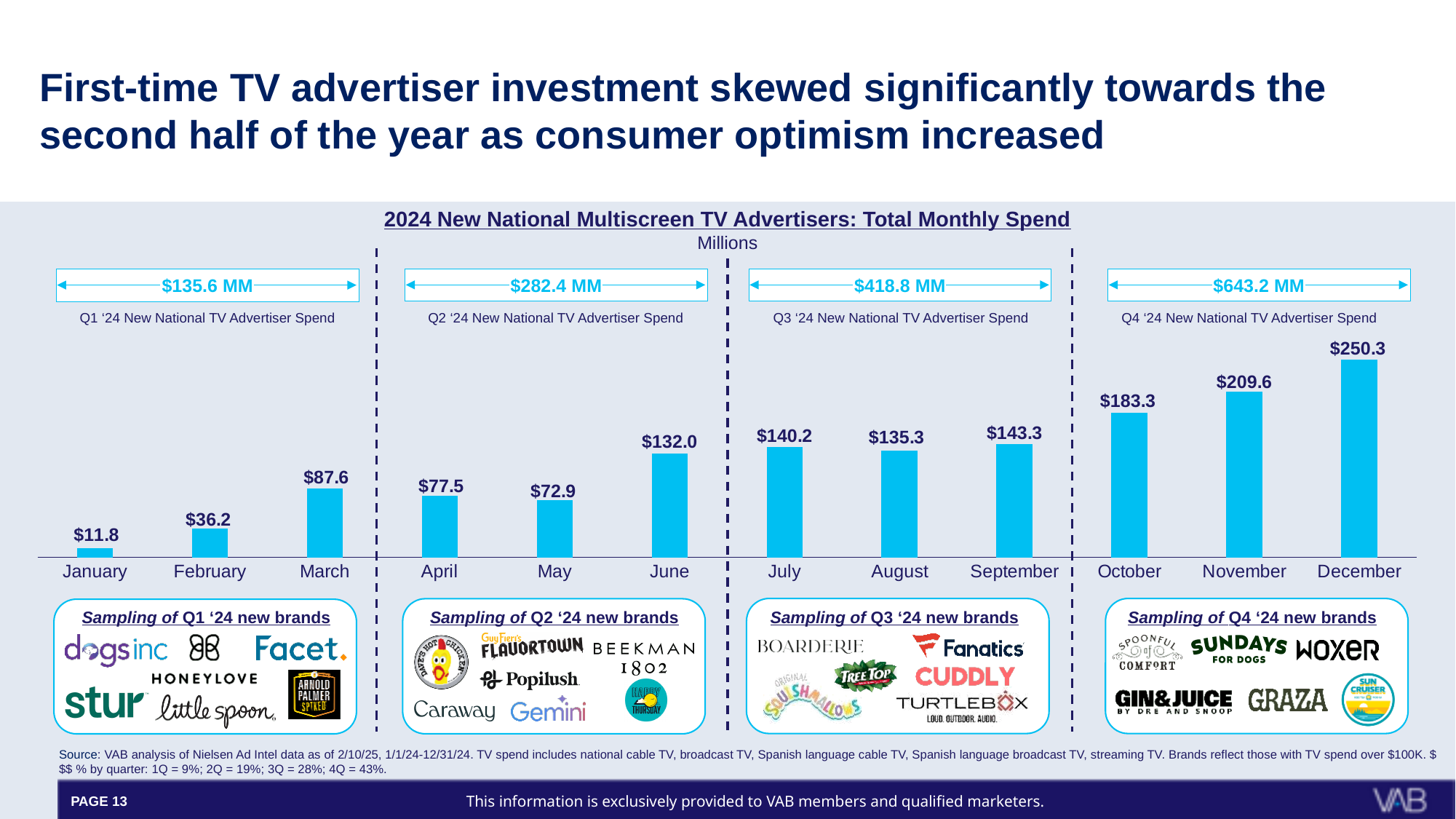
What is the value for July in the 2024 New National Multiscreen TV Advertisers: Total Monthly Spend chart? $140.2 What is the difference between the June and May values? $59.1 Which is larger, the value for April or the value for May? April What is the difference between the December and November values? $40.7 Which month has the lowest new national TV advertiser spend? January What kind of chart is used to show the monthly spend? Bar chart Do the monthly spend values generally rise or fall from January to December? Rise What is the value for March in the monthly spend chart? $87.6 What is the Q4 '24 New National TV Advertiser Spend total shown above the chart? $643.2 MM Which is larger, the value for August or the value for September? September Which month has the highest new national TV advertiser spend? December How many months are plotted in the chart? 12